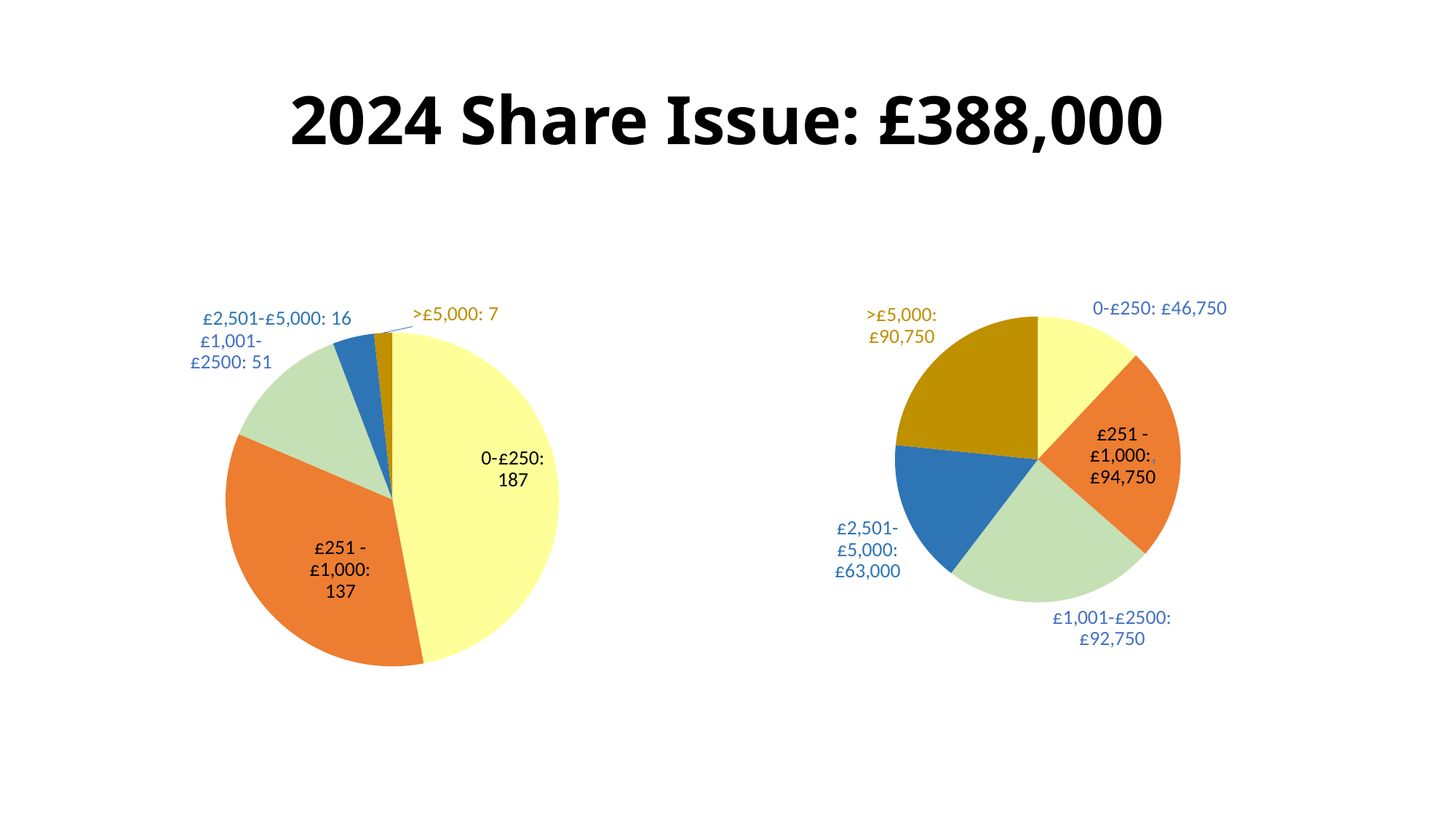
In the left pie chart, which band has the smallest value? >£5,000 In the left pie chart, which band has the largest value? 0-£250 In the left pie chart, how many shareholders are in the 0-£250 band? 187 In the left pie chart, what is the value for the >£5,000 band? 7 In the right pie chart, what is the difference between the £251 - £1,000 amount and the 0-£250 amount? £48,000 In the left pie chart, what is the value for the £251 - £1,000 band? 137 In the left pie chart, what is the difference between the 0-£250 value and the £251 - £1,000 value? 50 In the right pie chart, what amount is shown for the £2,501-£5,000 band? £63,000 In the right pie chart, which band has the smallest amount? 0-£250 In the right pie chart, which is larger: the amount for >£5,000 or the amount for £2,501-£5,000? >£5,000 How many slices does the left pie chart have? 5 In the right pie chart, what amount is shown for the £1,001-£2500 band? £92,750